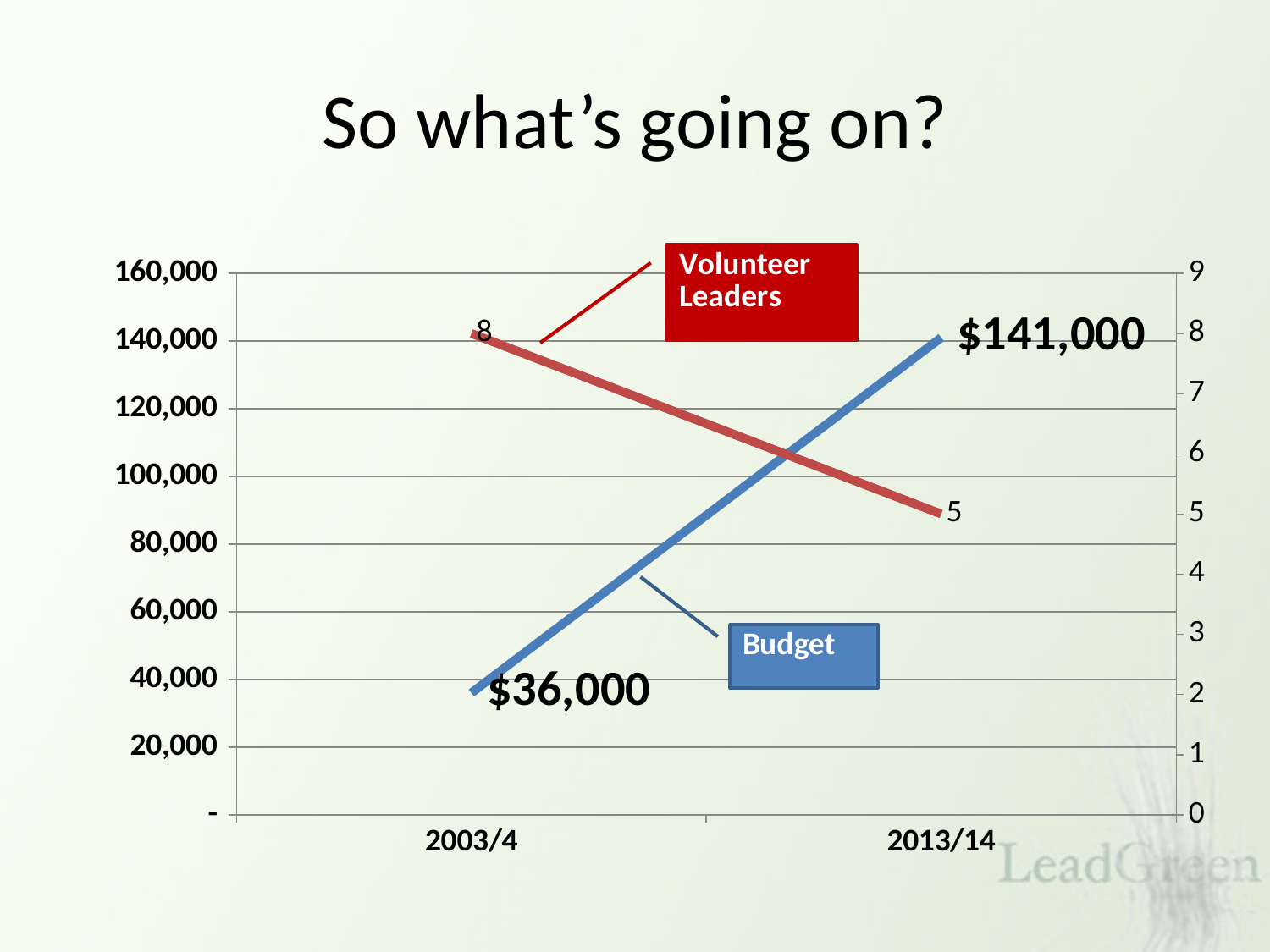
What colour is the Volunteer Leaders line? red By how many did the number of Volunteer Leaders fall from 2003/4 to 2013/14? 3 Does the Budget line rise or fall from 2003/4 to 2013/14? rise Does the Volunteer Leaders line rise or fall from 2003/4 to 2013/14? fall How many time periods are shown on the x axis? 2 What is the Budget value for 2013/14? $141,000 What is the Budget value for 2003/4? $36,000 How many Volunteer Leaders are shown for 2003/4? 8 How many Volunteer Leaders are shown for 2013/14? 5 By how much did the Budget increase from 2003/4 to 2013/14? $105,000 Which year has the higher Budget, 2003/4 or 2013/14? 2013/14 What type of chart is shown on the slide? line chart